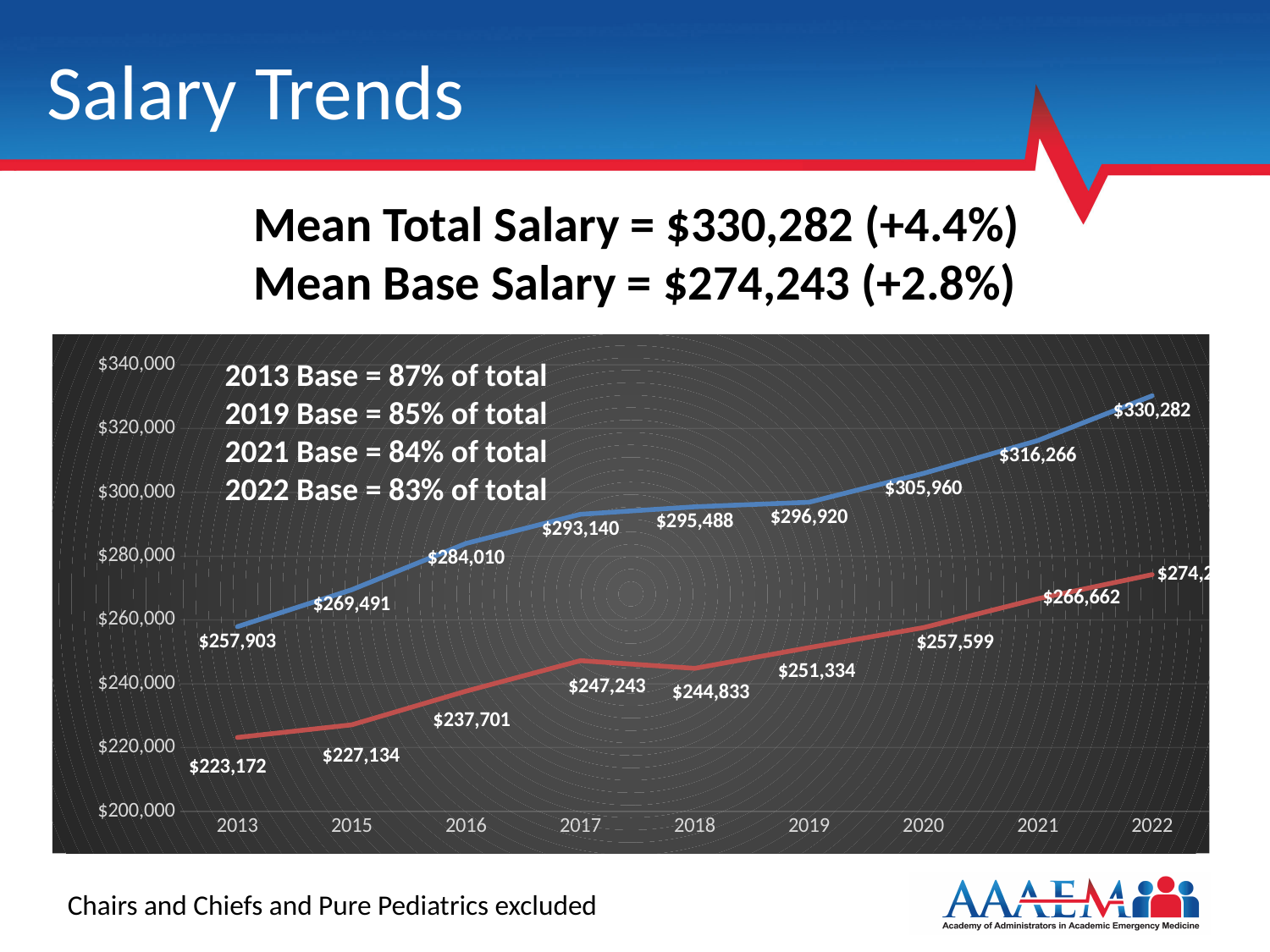
What is the mean base salary (lower red line) for 2016? $237,701 Which year has the larger mean base salary (lower red line), 2017 or 2018? 2017 What is the mean total salary (upper blue line) for 2013? $257,903 In which year is the mean base salary (lower red line) lowest? 2013 According to the text on the chart, what percentage of total salary was base salary in 2022? 83% What kind of chart is shown on the slide? line chart What is the difference between the mean base salary in 2017 and in 2018 (lower red line)? $2,410 What is the difference between the mean total salary and the mean base salary in 2013? $34,731 By how much did the mean total salary (upper blue line) increase from 2021 to 2022? $14,016 In which year is the mean total salary (upper blue line) highest? 2022 How many years are plotted along the x axis of the chart? 9 What is the mean total salary (upper blue line) for 2019? $296,920